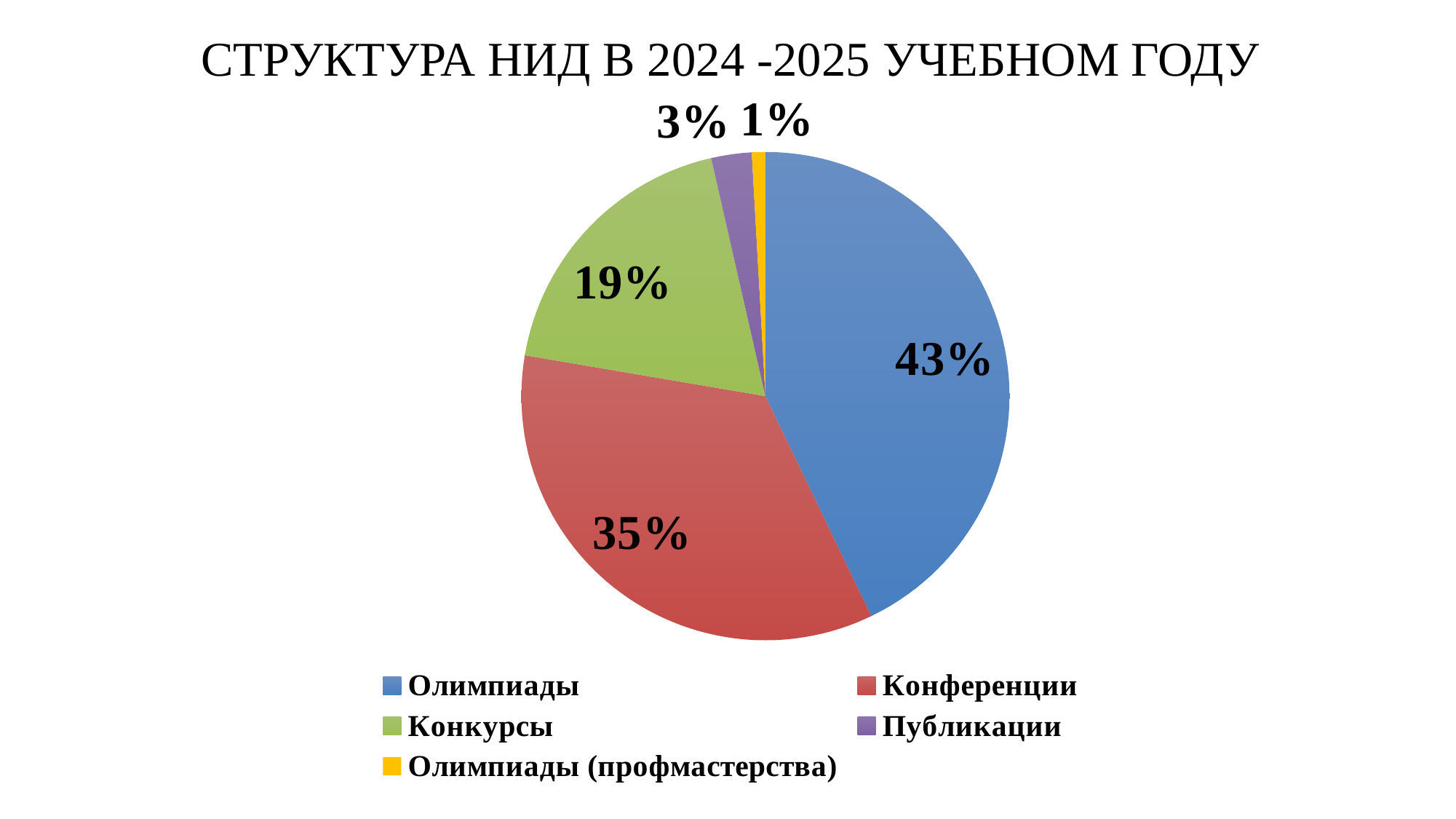
How many categories does the pie chart have? 5 What is the title of the chart? СТРУКТУРА НИД В 2024 -2025 УЧЕБНОМ ГОДУ What share of the pie does Конкурсы have? 19% Which category has the largest slice of the pie? Олимпиады What is the difference in percentage points between Олимпиады and Конференции? 8 Which category has the smallest slice of the pie? Олимпиады (профмастерства) What share of the pie does Олимпиады have? 43% What share of the pie does Конференции have? 35% Which is larger, the share for Конкурсы or the share for Публикации? Конкурсы What type of chart is shown on the slide? Pie chart